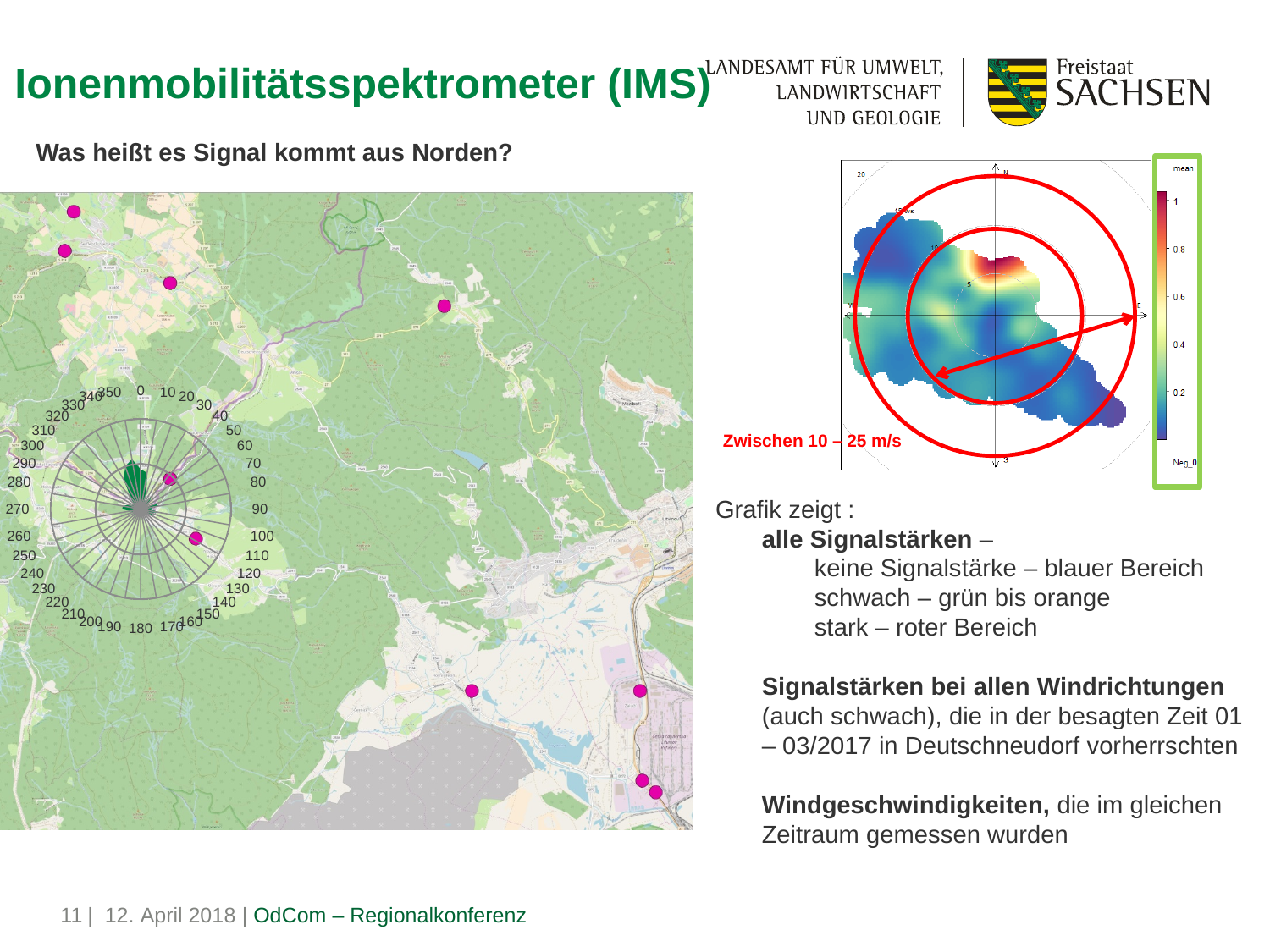
On the polar heatmap at the top right, what is the largest radial axis label shown? 20 On the polar chart overlaid on the map, what is the largest angular axis label shown? 350 On the polar heatmap at the top right, what is the highest tick value on the colour bar? 1 What kind of chart is overlaid on the map on the left side of the slide? polar chart (wind rose) On the polar chart overlaid on the map, how many angular axis labels are shown around the circle? 36 On the polar heatmap at the top right, what is the label at the top of the colour bar? mean What wind speed range is annotated in red next to the polar heatmap at the top right? Zwischen 10 – 25 m/s On the polar chart overlaid on the map, in what step size are the angular axis labels given? 10 On the polar chart overlaid on the map, toward which angular label does the green wedge point? 350 On the polar heatmap at the top right, in which compass direction does the red (strongest) region lie? N